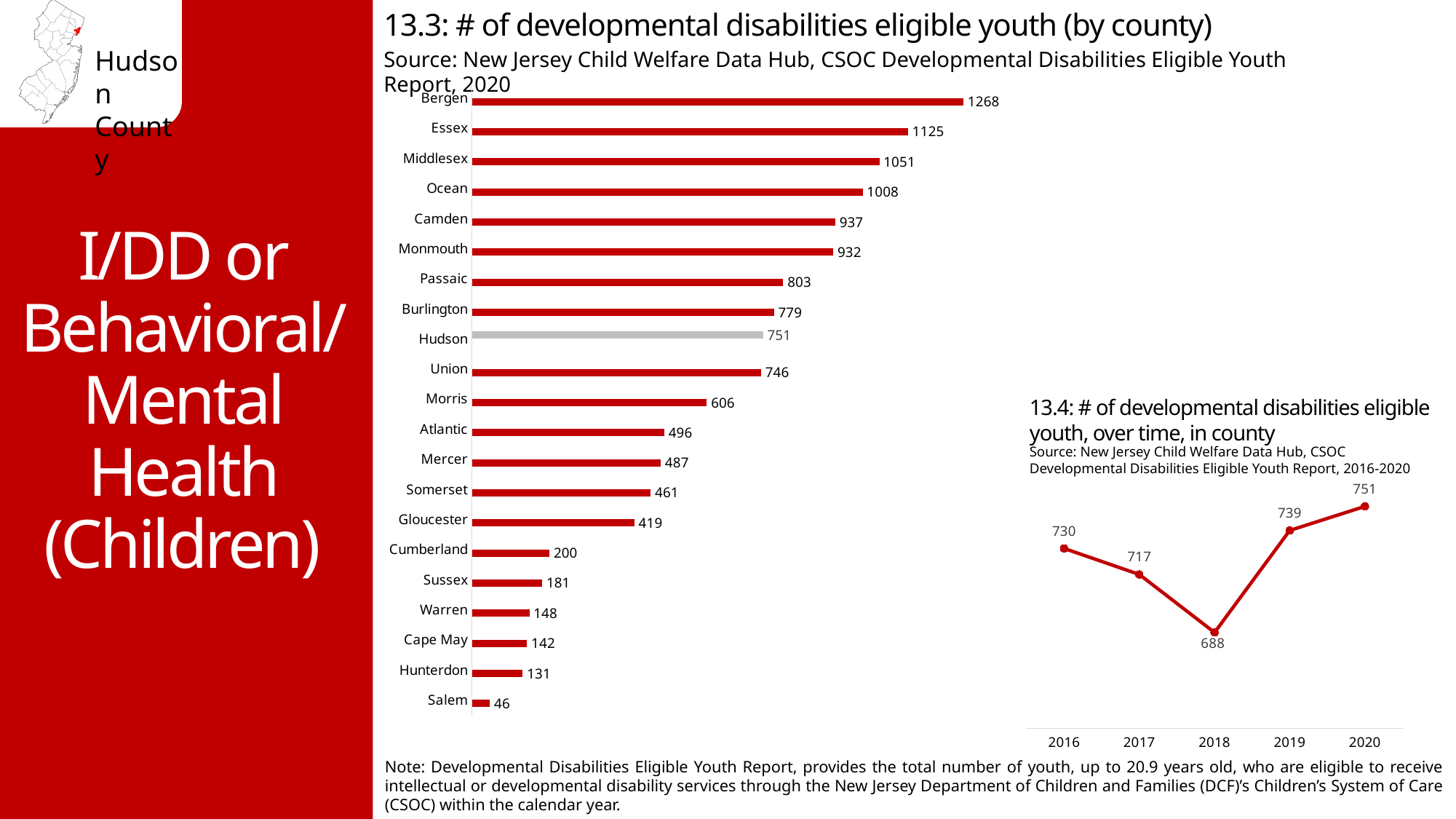
In chart 13.3 (by county), how many counties are shown? 21 In chart 13.3 (by county), which county has the highest number of developmental disabilities eligible youth? Bergen In chart 13.3 (by county), which county has the lowest number of developmental disabilities eligible youth? Salem In chart 13.4 (over time, in county), which year has the highest value? 2020 In chart 13.3 (by county), which has a larger value, Camden or Passaic? Camden In chart 13.3 (by county), what is the difference between the values for Bergen and Essex? 143 What kind of chart is chart 13.3 (# of developmental disabilities eligible youth by county)? Bar chart In chart 13.4 (over time, in county), what is the value for 2018? 688 What kind of chart is chart 13.4 (# of developmental disabilities eligible youth over time, in county)? Line chart In chart 13.3 (by county), what is the value for Cumberland? 200 In chart 13.4 (over time, in county), what is the difference between the 2020 and 2016 values? 21 In chart 13.3 (# of developmental disabilities eligible youth by county), what is the value for Hudson? 751